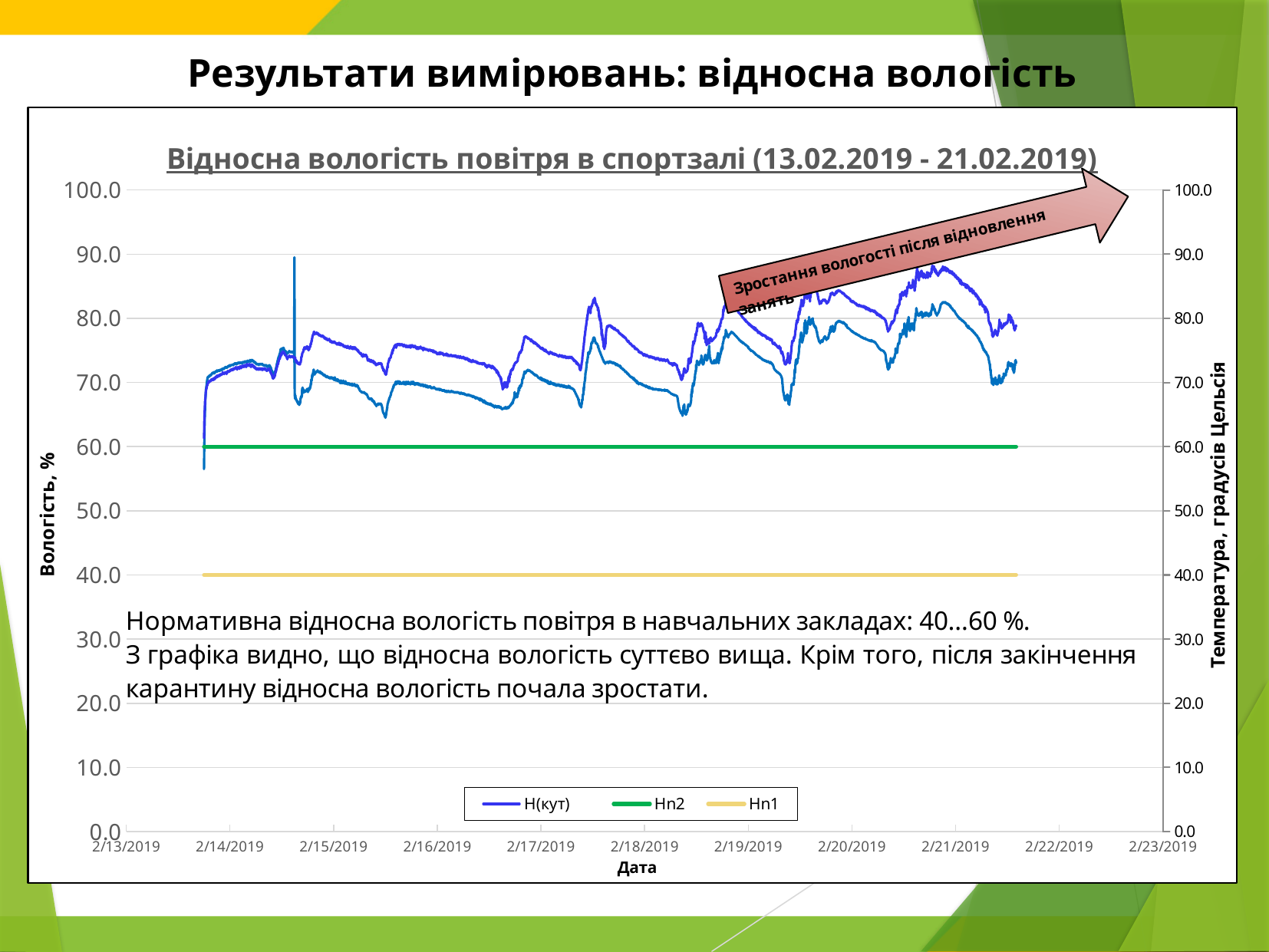
What is the title of the x axis? Дата Is the value of Н(кут) on 2/20/2019 greater or less than 70.0? greater How many series does the legend list? 3 Which series has the lowest values on the chart? Нп1 What kind of chart is shown on the slide? line chart Is the value of Н(кут) on 2/16/2019 greater or less than 60.0? greater Does the Н(кут) series generally rise or fall between 2/19/2019 and 2/21/2019? rise Which series has the highest values on the chart? Н(кут) Which is larger, the Нп2 line or the Нп1 line? Нп2 What is the constant value of the Нп1 series? 40.0 What is the difference between the Нп2 line and the Нп1 line? 20.0 What is the constant value of the Нп2 series? 60.0